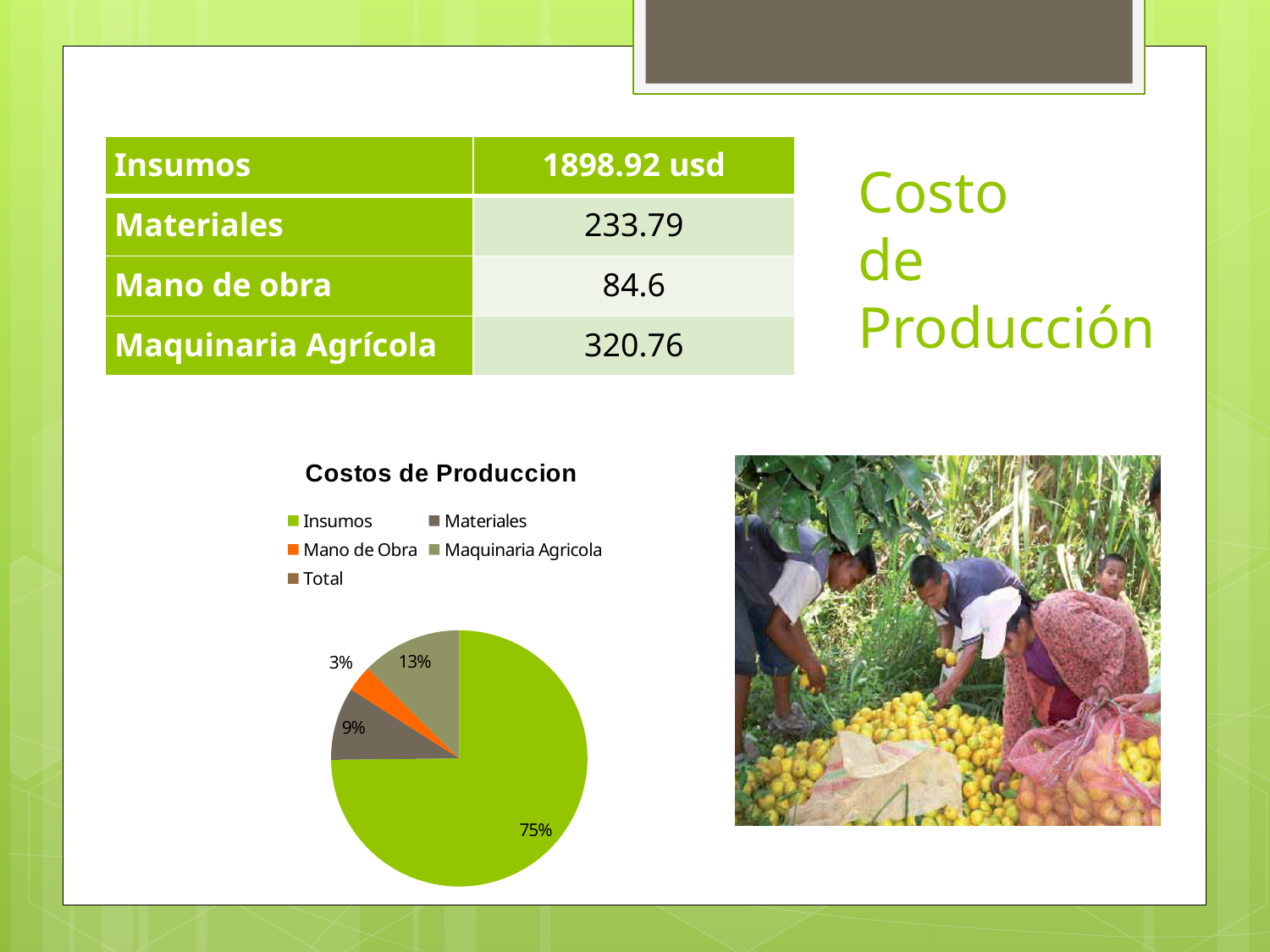
What share of the pie does Maquinaria Agricola take? 13% Which slice is larger, Materiales or Maquinaria Agricola? Maquinaria Agricola Which category has the largest slice of the pie? Insumos How many slices with percentage labels are shown in the pie? 4 What is the title of the chart? Costos de Produccion How many entries does the chart legend list? 5 What share of the pie does Insumos take? 75% What share of the pie does Mano de Obra take? 3% Which category has the smallest slice of the pie? Mano de Obra What kind of chart is shown on the slide? pie chart What is the difference in percentage points between the Insumos slice and the Maquinaria Agricola slice? 62